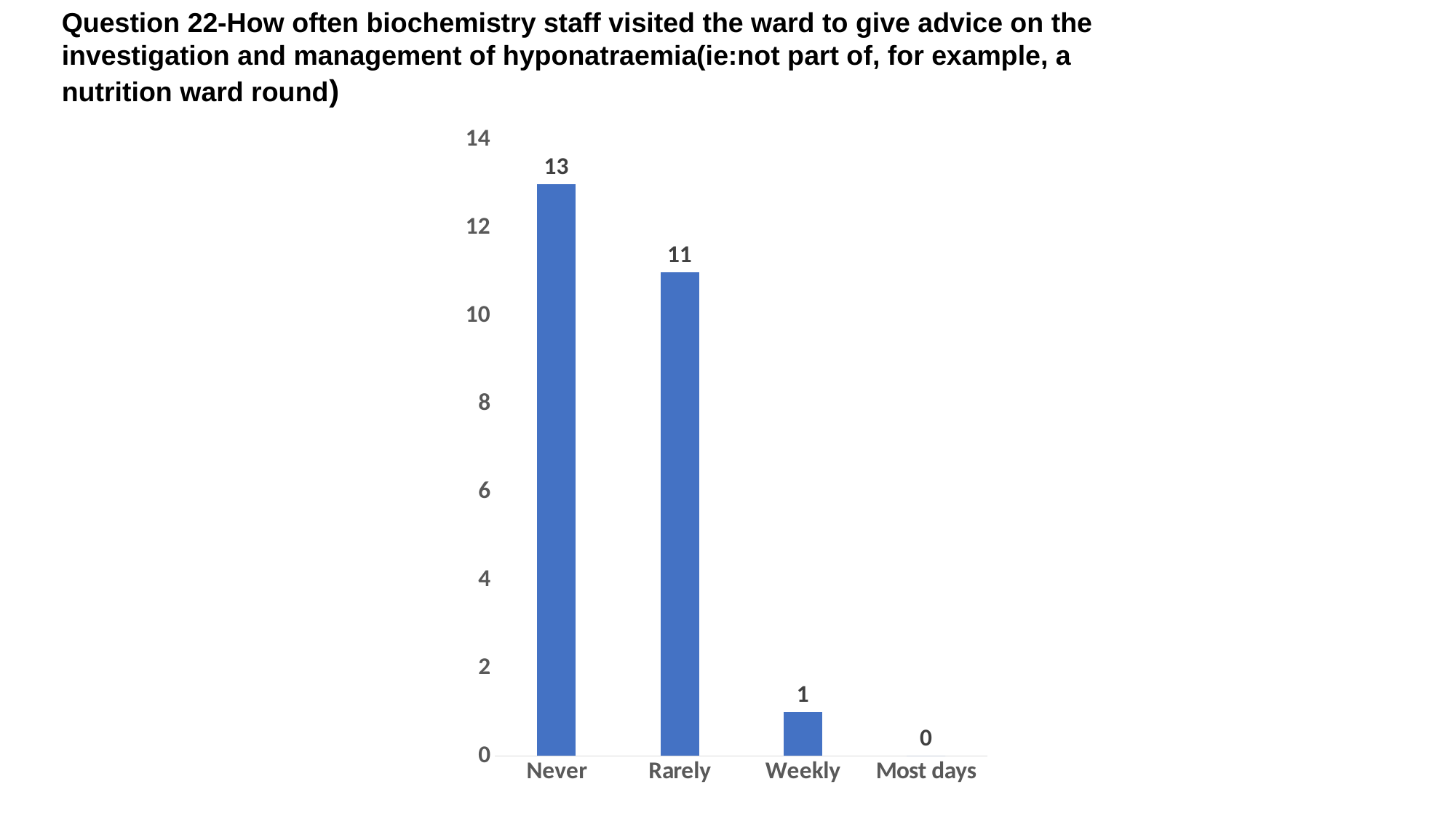
What kind of chart is shown on the slide? bar chart What is the value for Rarely? 11 Which category has the lowest value? Most days Which is larger, the value for Never or the value for Rarely? Never Is the value for Rarely greater or less than 10? greater Which category has the highest value? Never What is the value for Most days? 0 What is the difference between the values for Never and Rarely? 2 How many categories are shown on the x axis? 4 What is the value for Weekly? 1 What is the value for Never? 13 What is the difference between the values for Rarely and Weekly? 10